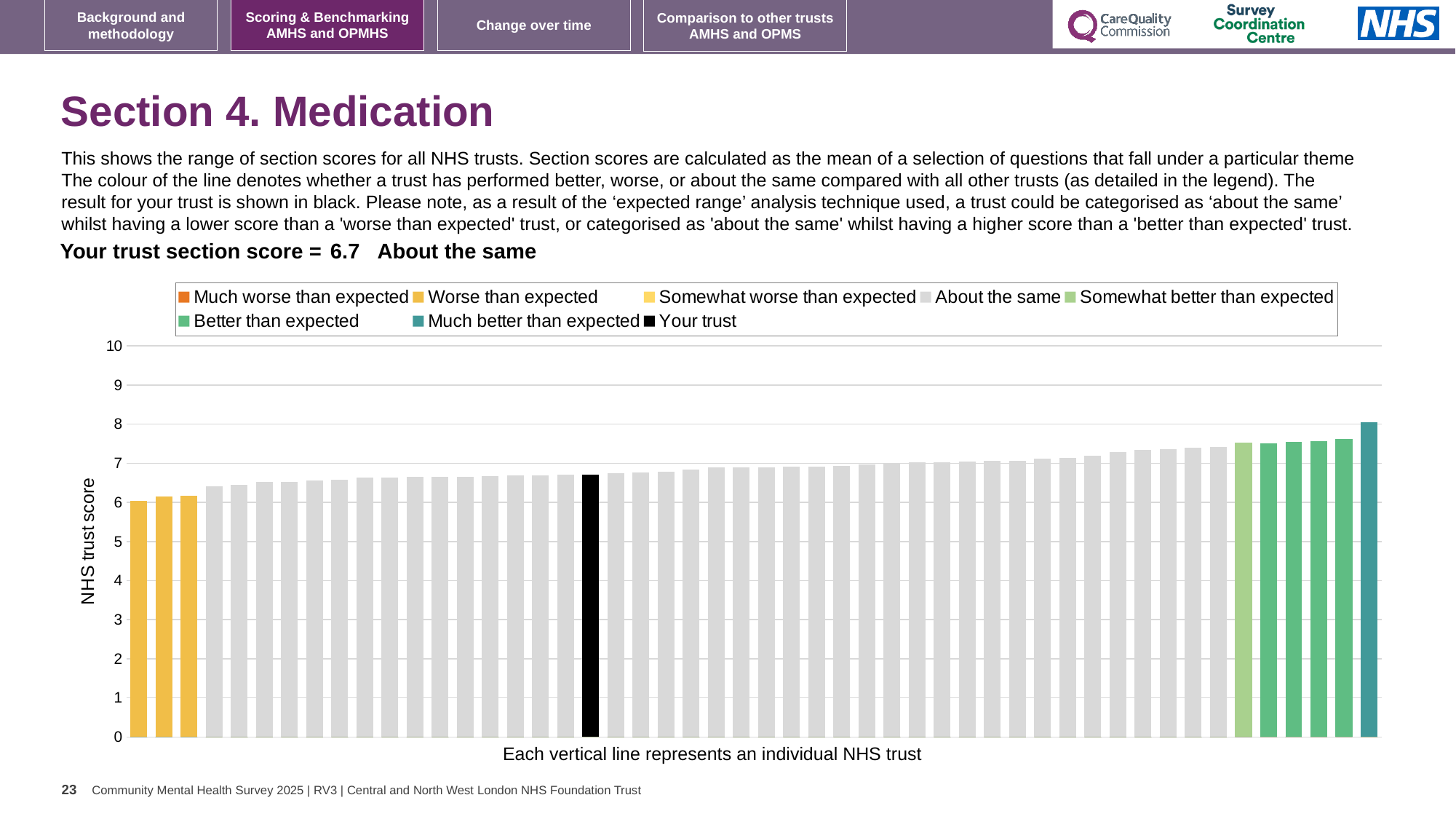
Which legend category does the tallest bar in the chart belong to? Much better than expected Is the value of the black 'Your trust' bar greater or less than 5? greater What is the section score for your trust shown on the slide? 6.7 What is the label of the y axis? NHS trust score Is the value of the tallest bar in the chart greater or less than 7? greater Which legend category does the shortest bar in the chart belong to? Worse than expected Is the value of the lowest bar in the chart greater or less than 7? less Do the bar values rise or fall from left to right along the x axis? rise What kind of chart is shown on the slide? bar chart How many bars are coloured as 'Worse than expected'? 3 How many entries does the chart legend list? 8 Which category is your trust's section score placed in, according to the text above the chart? About the same